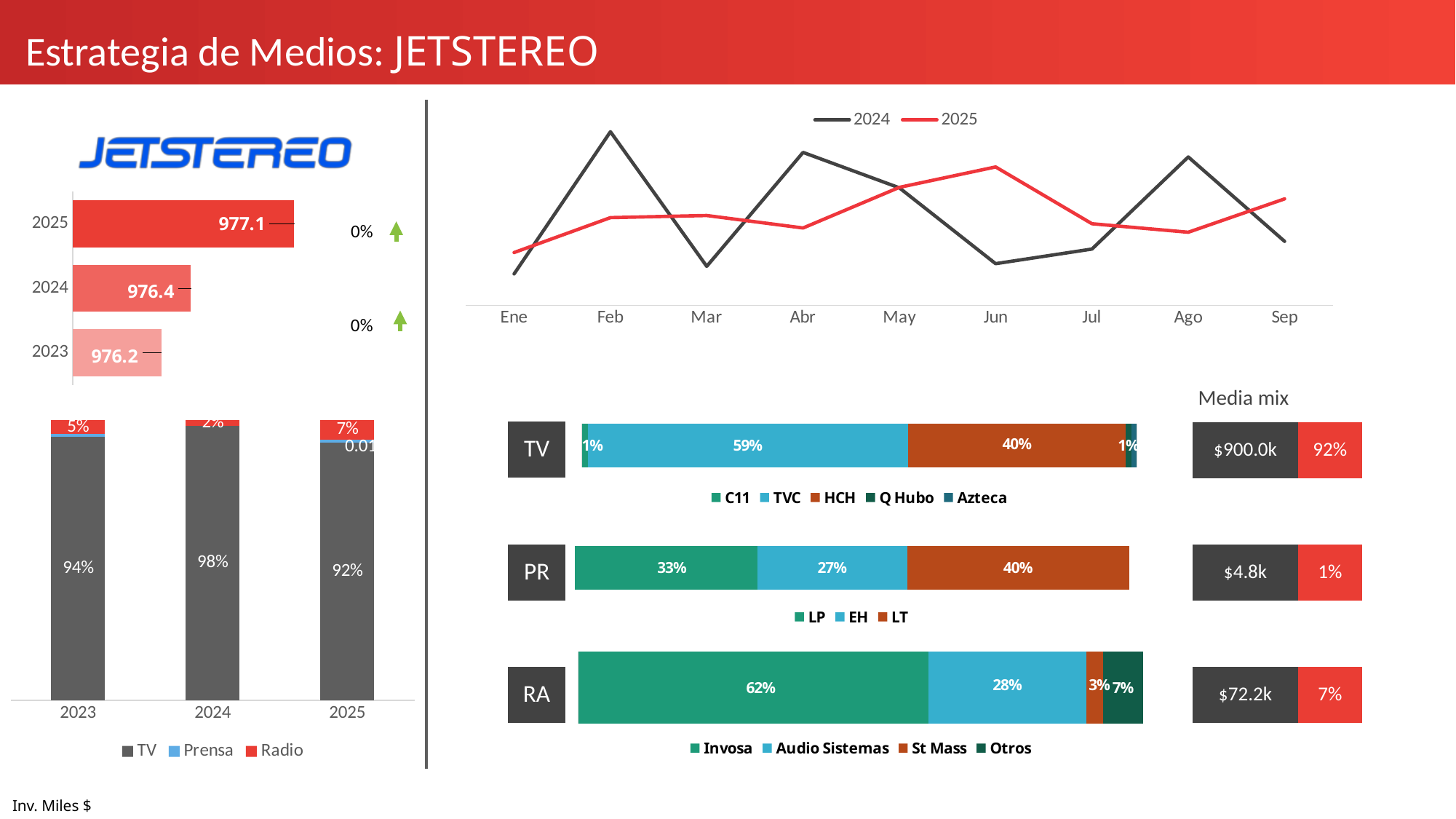
In the RA stacked bar, what is the share for Audio Sistemas? 28% In the stacked bar chart at the bottom left, how many series does the legend list? 3 In the horizontal bar chart on the left, what is the difference between the 2025 and 2024 values? 0.7 In the TV stacked bar, what is the share for TVC? 59% In the stacked bar chart at the bottom left, what is the TV share for 2024? 98% In the horizontal bar chart on the left, which year has the lowest value? 2023 In the PR stacked bar, which channel has the largest share? LT In the line chart at the top right, how many months are shown on the x axis? 9 In the line chart at the top right, which series is higher in Feb, 2024 or 2025? 2024 In the Media mix table, what is the investment amount shown for RA? $72.2k In the stacked bar chart at the bottom left, what is the Radio share for 2025? 7% In the horizontal bar chart on the left, what is the value for 2025? 977.1